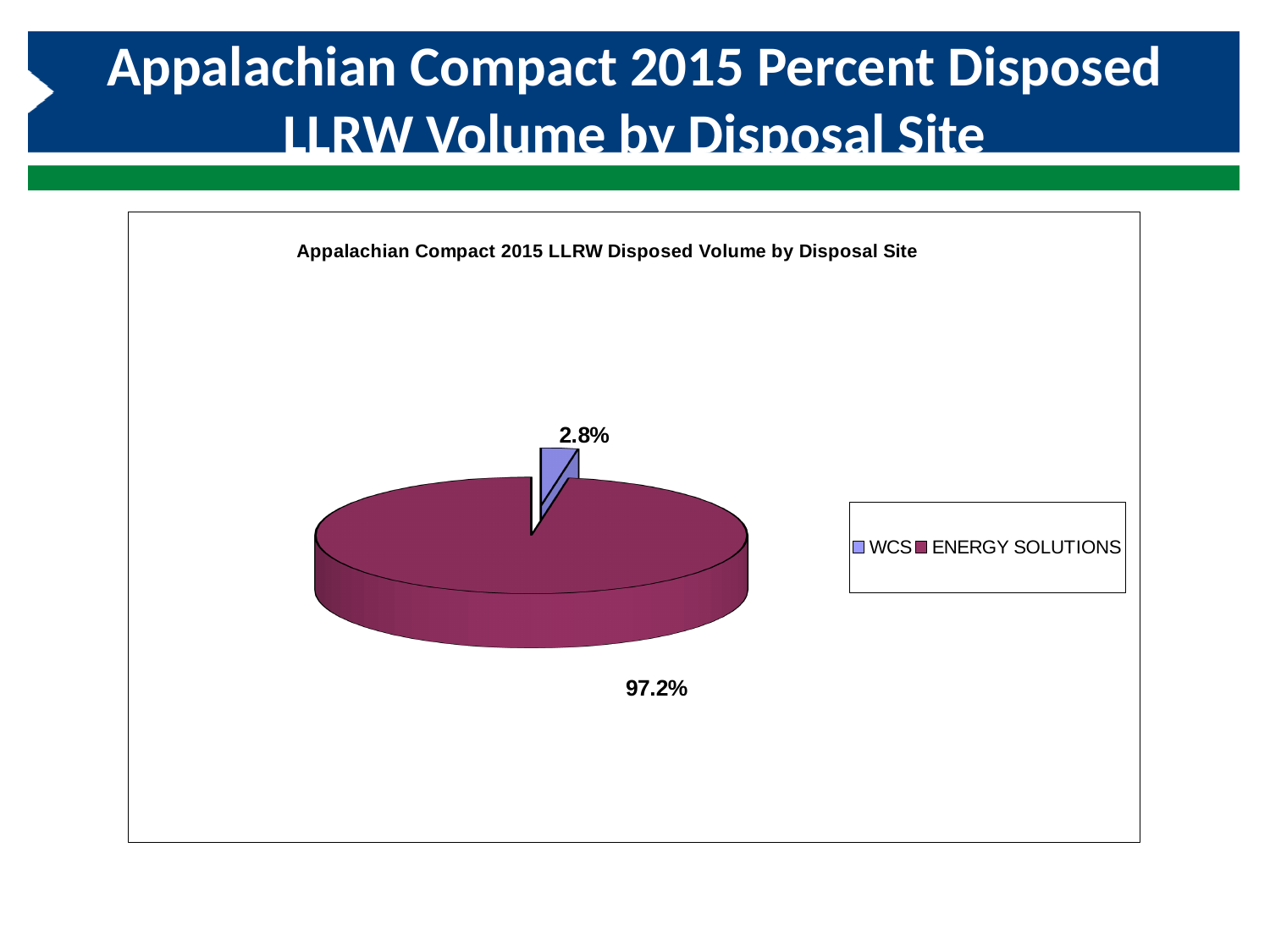
What kind of chart is shown on the slide? pie chart Which is larger, the share for WCS or the share for ENERGY SOLUTIONS? ENERGY SOLUTIONS Which disposal site has the largest share of the pie? ENERGY SOLUTIONS Which disposal site has the smallest share of the pie? WCS What percentage of the disposed volume is attributed to WCS? 2.8% How many slices does the pie chart have? 2 What percentage of the disposed volume is attributed to ENERGY SOLUTIONS? 97.2% What is the difference in percentage points between the ENERGY SOLUTIONS share and the WCS share? 94.4 What colour is the slice representing ENERGY SOLUTIONS? magenta/purple What is the total of the two percentages shown on the pie chart? 100% What is the title of the chart? Appalachian Compact 2015 LLRW Disposed Volume by Disposal Site How many entries does the legend list? 2